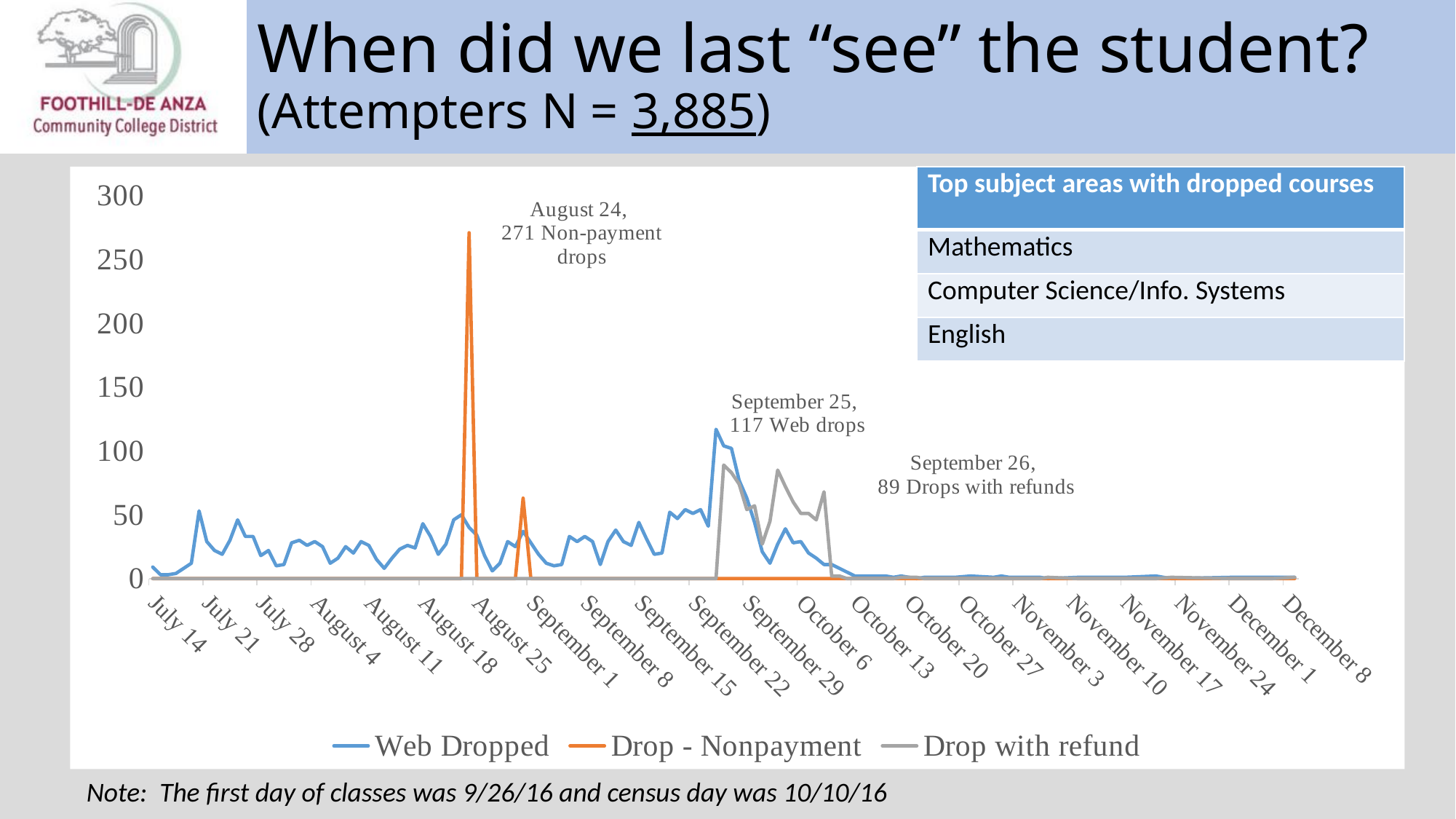
Which series reaches the highest peak on the chart? Drop - Nonpayment How many Drop - Nonpayment drops occurred on August 24 according to the chart annotation? 271 Is the second spike of the Drop - Nonpayment line, around August 31, greater or less than 100? less How many Web drops occurred on September 25 according to the chart annotation? 117 Which is larger: the peak of Web Dropped or the peak of Drop with refund? Web Dropped What colour is the Web Dropped line in the legend? blue How many series does the chart's legend list? 3 After its September 25 peak, does the Web Dropped line rise or fall through October? fall What is the difference between the September 25 Web drops peak and the September 26 Drops with refunds peak? 28 How many Drops with refunds occurred on September 26 according to the chart annotation? 89 What kind of chart is shown on the slide? line chart What is the difference between the August 24 Non-payment drops peak and the September 25 Web drops peak? 154